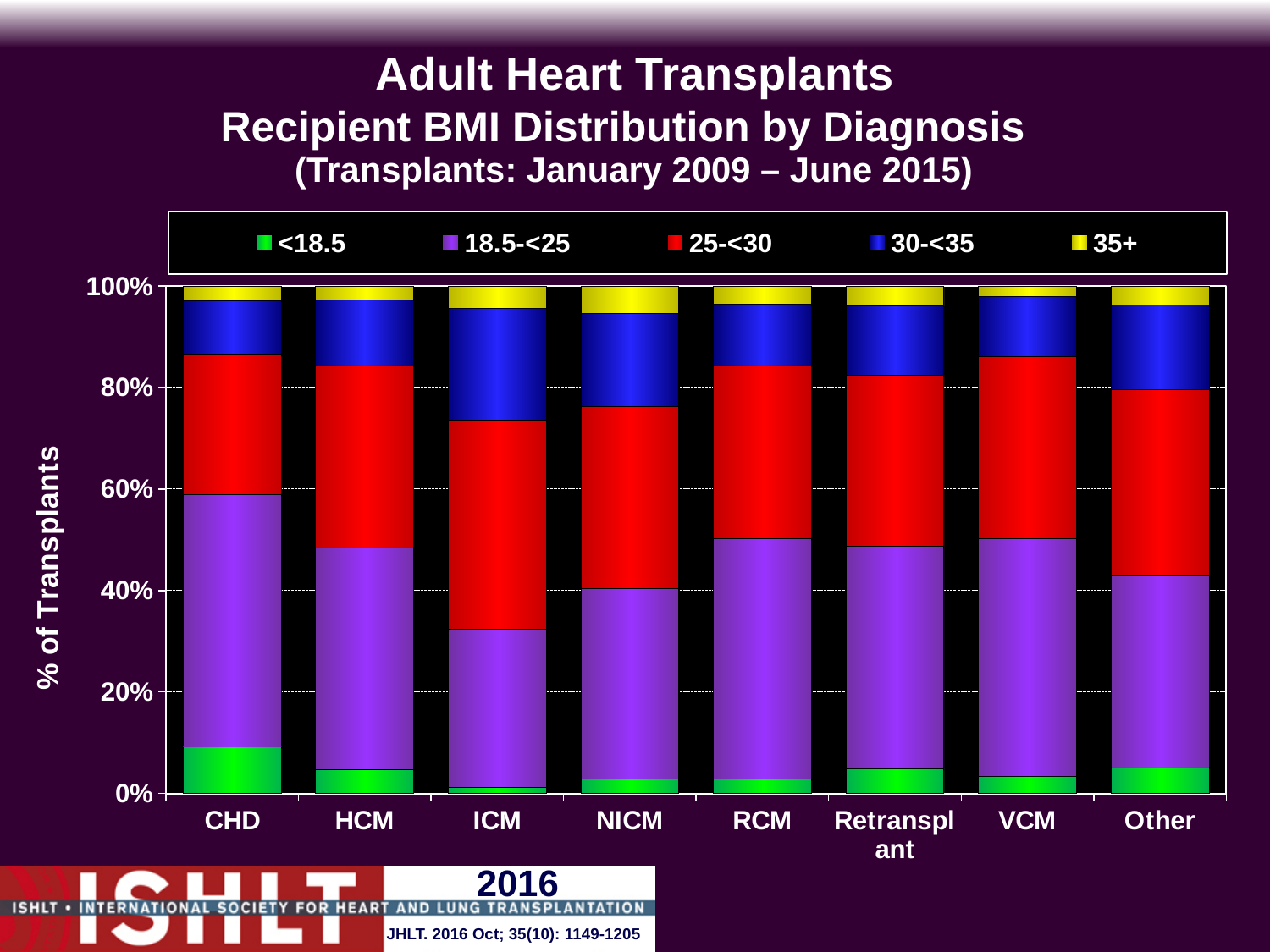
Is the 18.5-<25 segment larger for CHD or for ICM? CHD Is the 25-<30 segment larger for ICM or for CHD? ICM How many diagnosis categories are shown along the x axis? 8 What is the label on the y axis? % of Transplants Which diagnosis has the largest <18.5 BMI segment? CHD Is the <18.5 segment for CHD greater or less than 20%? less How many BMI series does the legend list? 5 What kind of chart is shown on the slide? Stacked bar chart Is the 30-<35 segment larger for ICM or for CHD? ICM Is the 18.5-<25 segment for ICM greater or less than 40%? less Which diagnosis has the smallest 18.5-<25 BMI segment? ICM Which diagnosis has the smallest <18.5 BMI segment? ICM